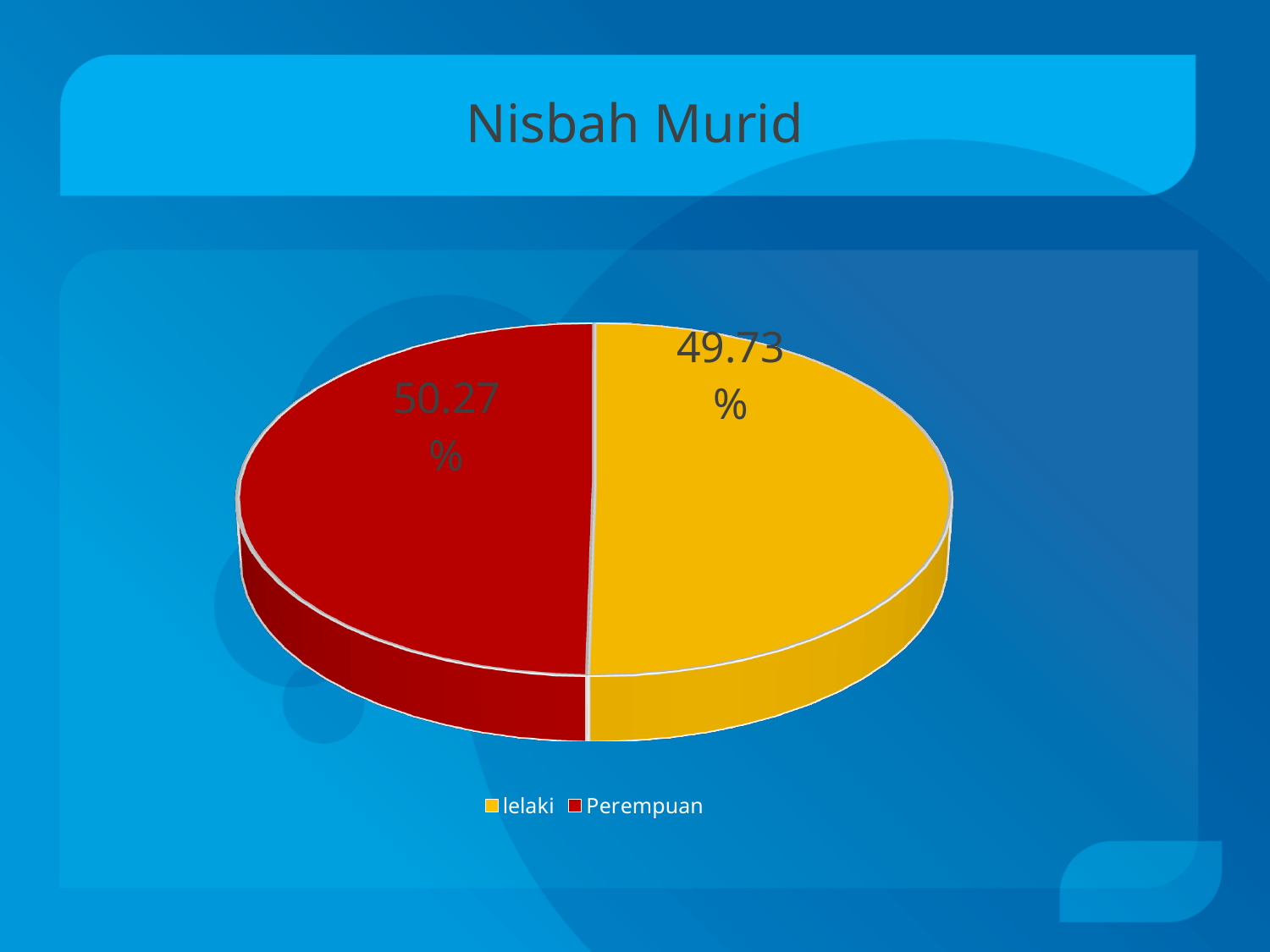
Which slice is larger, lelaki or Perempuan? Perempuan How many entries does the legend list? 2 What colour is the lelaki slice? Yellow What is the title of the chart? Nisbah Murid What is the difference between the Perempuan share and the lelaki share? 0.54% What type of chart is shown on the slide? Pie chart What percentage of the pie is labelled for lelaki? 49.73% Which category has the smallest share of the pie? lelaki What is the share of the pie for Perempuan? 50.27% How many slices does the pie chart have? 2 What percentage of the pie is labelled for Perempuan? 50.27% Which category has the largest share of the pie? Perempuan